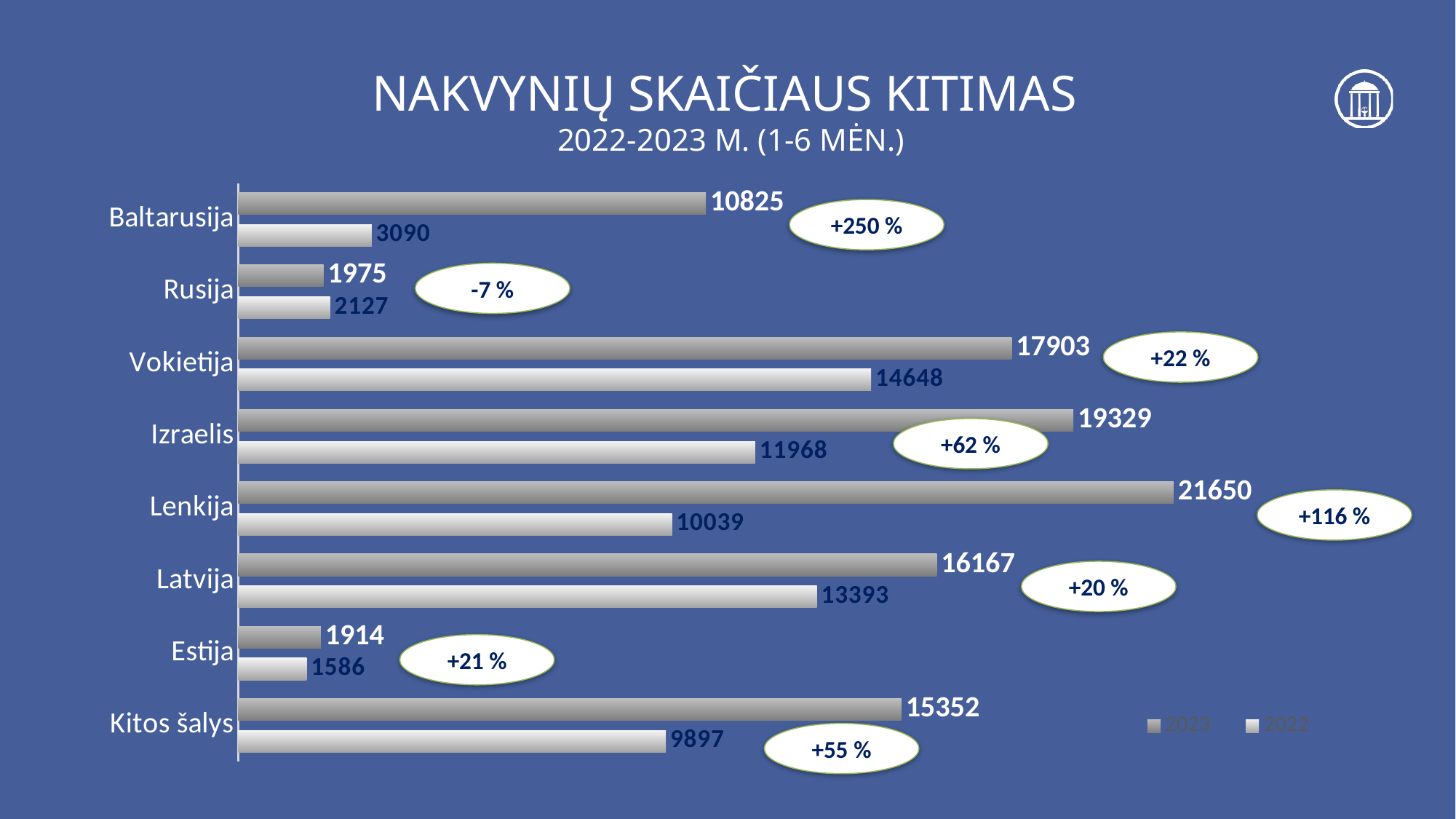
Which is larger for Rusija, the 2023 value or the 2022 value? 2022 What percentage change is shown next to Baltarusija? +250 % What is the 2023 value for Lenkija? 21650 What kind of chart is shown on the slide? Bar chart Which category has the lowest 2022 value? Estija Which category has the highest 2023 value? Lenkija What is the 2022 value for Vokietija? 14648 How many series does the legend list? 2 What is the 2022 value for Baltarusija? 3090 What is the title of the chart? NAKVYNIŲ SKAIČIAUS KITIMAS 2022-2023 M. (1-6 MĖN.) How many categories are shown on the chart? 8 What is the difference between the 2023 and 2022 values for Izraelis? 7361